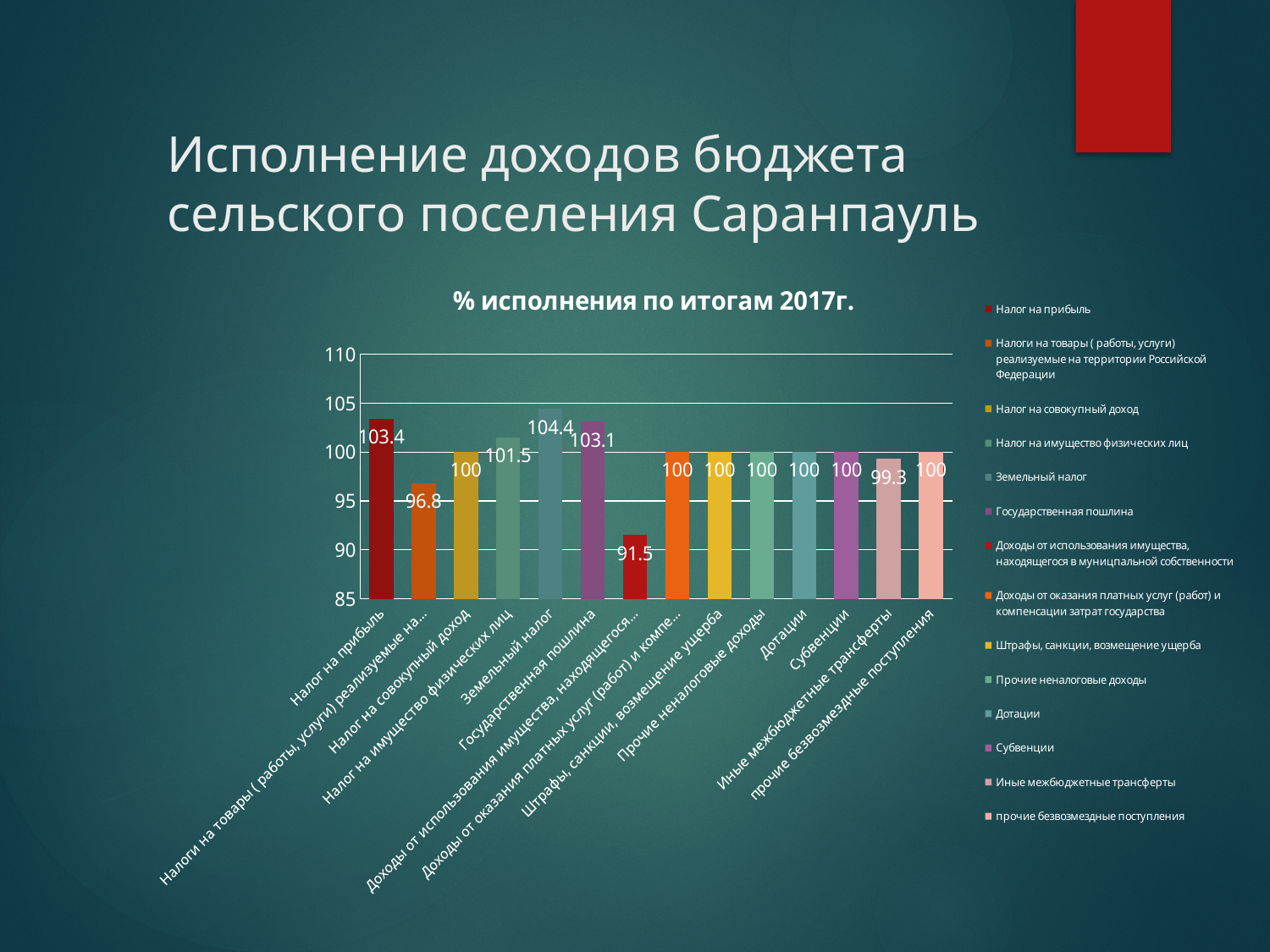
What is the title of the chart? % исполнения по итогам 2017г. What is the value for Земельный налог? 104.4 Which category has the highest value? Земельный налог What is the value for Государственная пошлина? 103.1 What is the value for Иные межбюджетные трансферты? 99.3 What is the difference between the values for Земельный налог and Налог на имущество физических лиц? 2.9 How many bars are plotted in the chart? 14 What is the value for Налог на прибыль? 103.4 Is the value for Дотации greater or less than 95? greater What kind of chart is shown on the slide? Bar chart Which category has the lowest value? Доходы от использования имущества, находящегося в муниципальной собственности Which is larger, the value for Налог на прибыль or the value for Государственная пошлина? Налог на прибыль